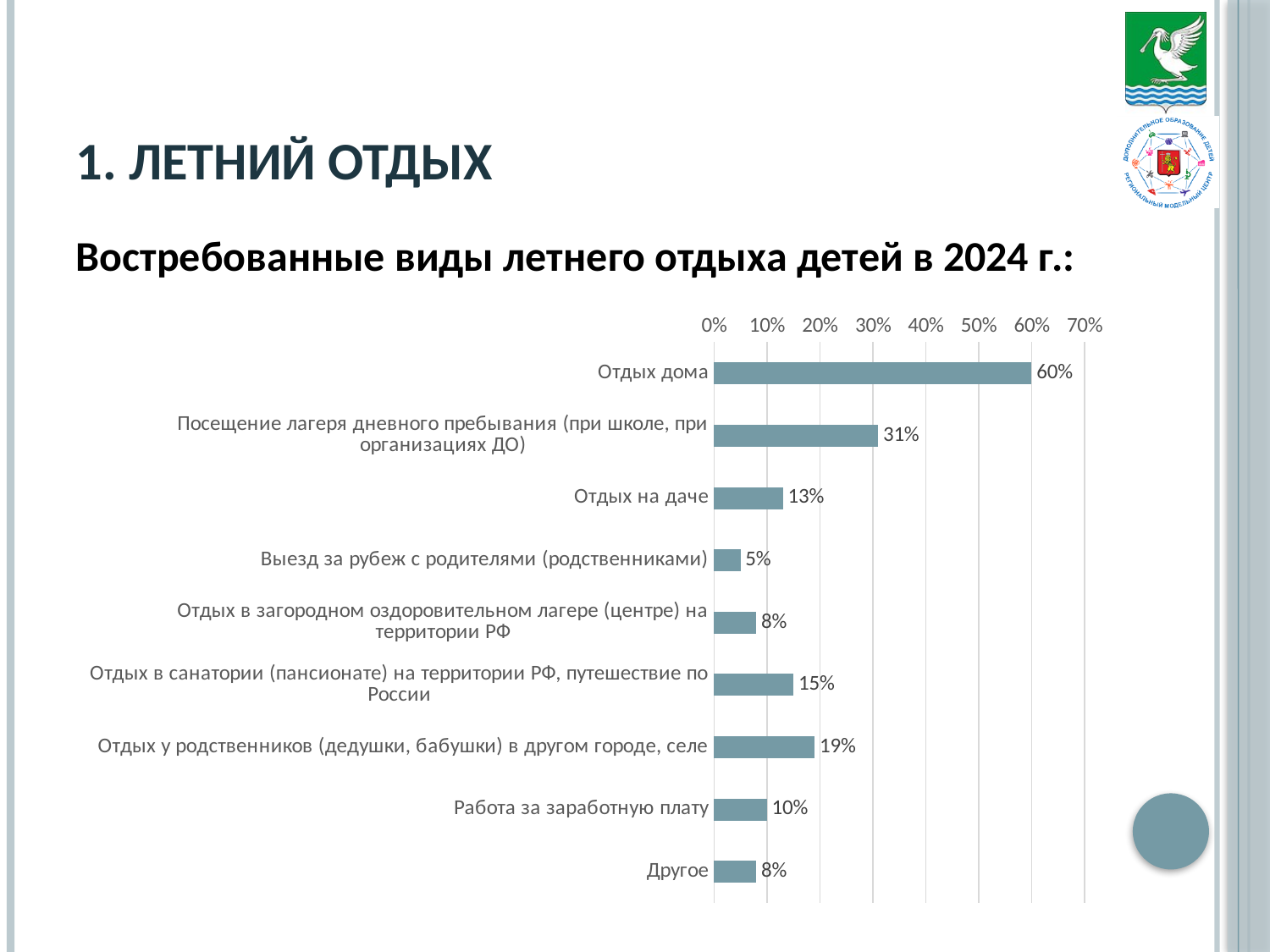
Which is larger: «Отдых на даче» or «Отдых в санатории (пансионате) на территории РФ, путешествие по России»? Отдых в санатории (пансионате) на территории РФ, путешествие по России What is the value for «Посещение лагеря дневного пребывания (при школе, при организациях ДО)»? 31% What is the value for «Отдых у родственников (дедушки, бабушки) в другом городе, селе»? 19% What is the value for «Отдых дома»? 60% Which category has the highest value? Отдых дома What is the value for «Работа за заработную плату»? 10% How many categories are shown in the chart? 9 Which category has the lowest value? Выезд за рубеж с родителями (родственниками) Is the value for «Отдых дома» greater or less than 50%? greater What kind of chart is shown on the slide? bar chart What is the title of the chart on the slide? Востребованные виды летнего отдыха детей в 2024 г.: What is the difference between «Отдых дома» and «Посещение лагеря дневного пребывания (при школе, при организациях ДО)»? 29%